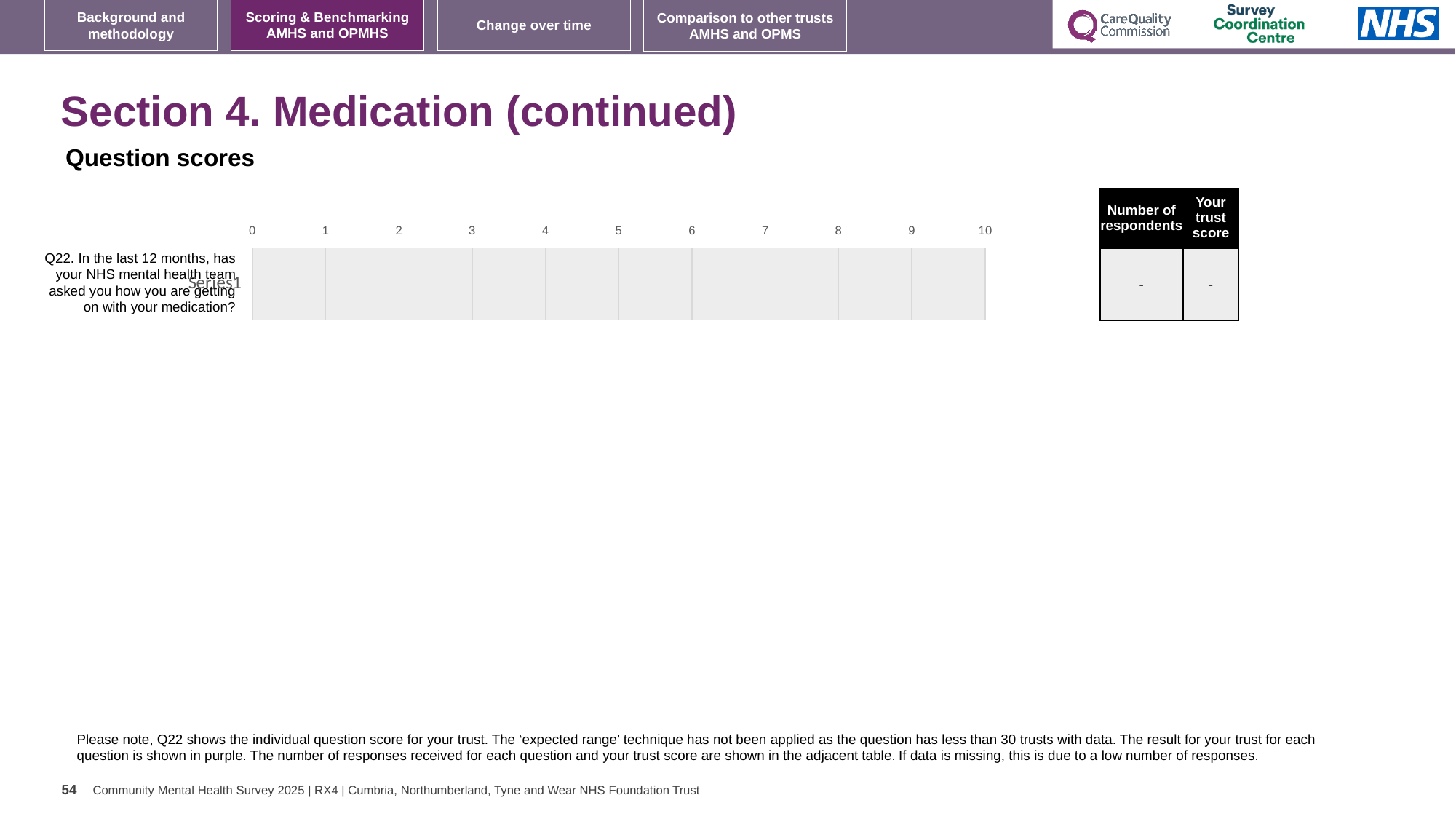
What is shown in the 'Your trust score' column of the table for Q22? - How many questions (categories) are listed on the chart? 1 What kind of chart is shown on the slide for the question scores? bar chart What is shown in the 'Number of respondents' column of the table for Q22? - What is the highest tick value shown on the chart's horizontal axis? 10 Which question is listed as the category on the chart? Q22. In the last 12 months, has your NHS mental health team asked you how you are getting on with your medication? What series name is displayed on the chart? Series1 Is a bar with a value plotted for Q22 on the chart? No